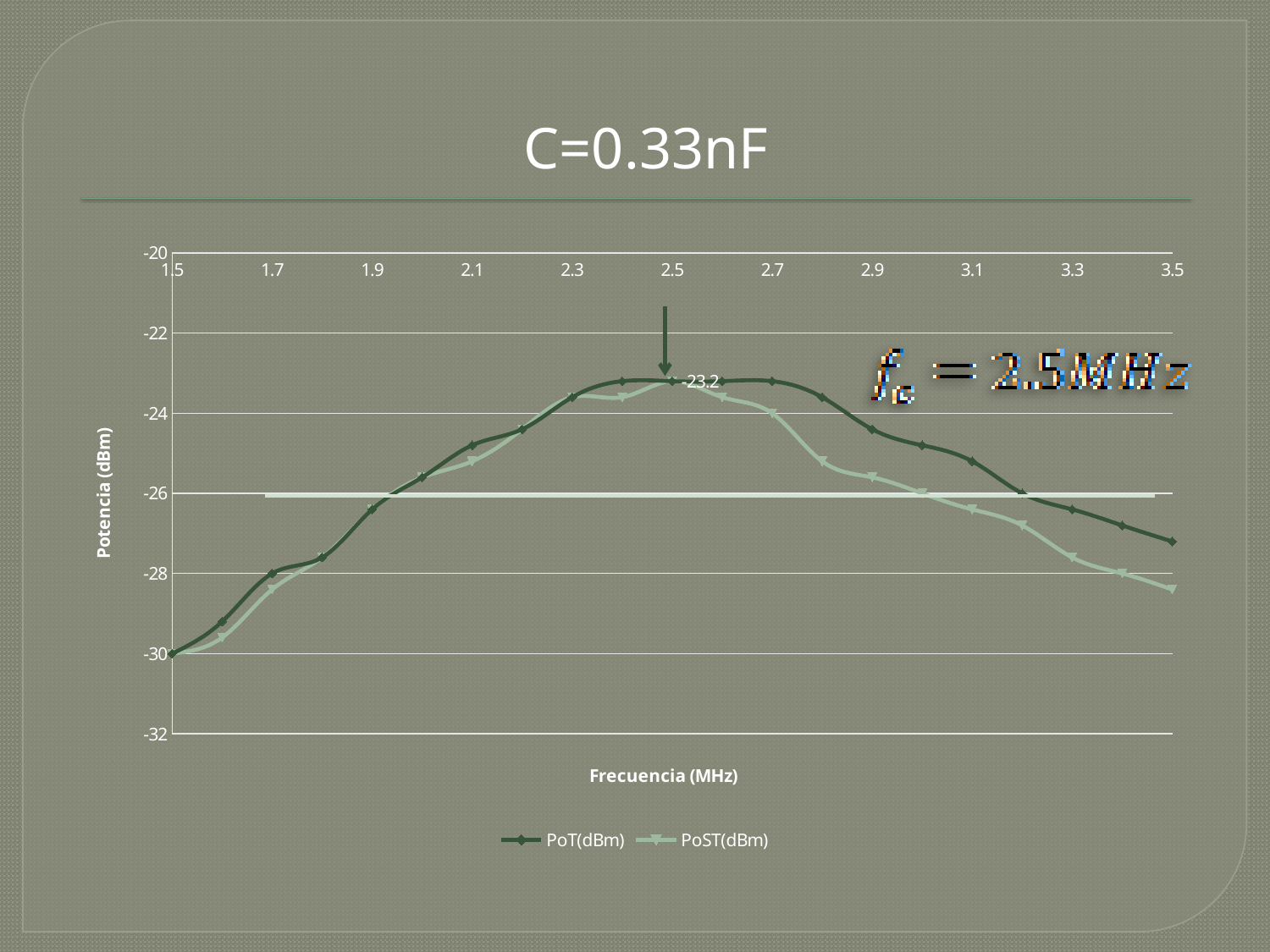
Is the PoT(dBm) value at 1.5 MHz greater or less than -28? less Is the PoT(dBm) value at 2.3 MHz greater or less than -24? greater What is the PoT(dBm) value at 1.5 MHz? -30 Is the PoST(dBm) value at 3.5 MHz greater or less than -26? less What is the title of the chart? C=0.33nF What is the PoT(dBm) value at 2.5 MHz? -23.2 What kind of chart is shown on the slide? line chart Does the PoT(dBm) series rise or fall between 1.5 MHz and 2.5 MHz? rise What is the label of the x axis? Frecuencia (MHz) At 3.5 MHz, which series has the higher value, PoT(dBm) or PoST(dBm)? PoT(dBm) Does the PoT(dBm) series rise or fall between 2.7 MHz and 3.5 MHz? fall How many series does the legend list? 2